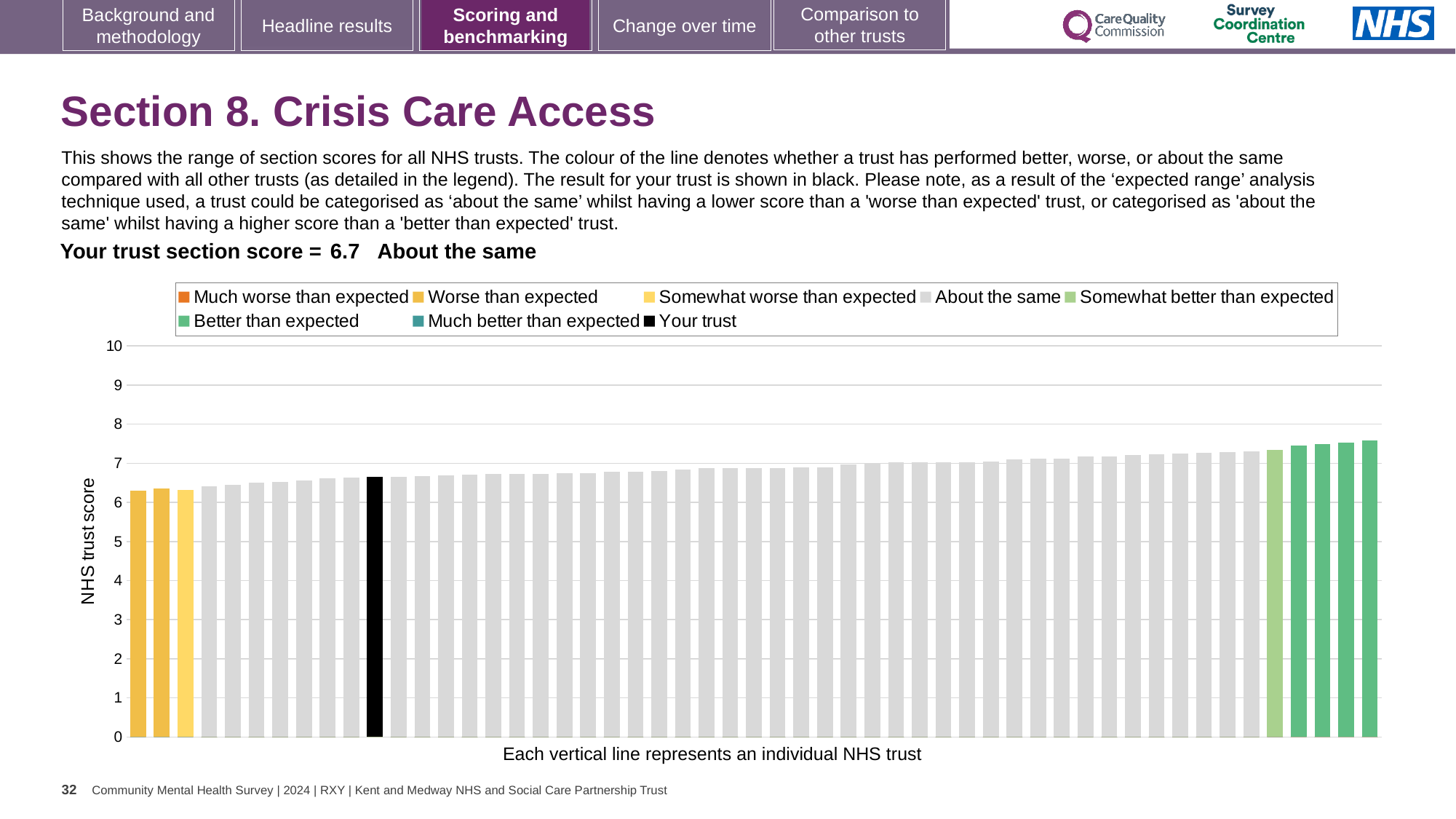
What is the label on the vertical axis of the chart? NHS trust score What is the section score for your trust shown on the slide? 6.7 What colour is the bar representing your trust? black Which legend category does the tallest bar on the chart belong to? Better than expected Is the value of the tallest bar on the chart greater or less than 7? greater How many entries does the chart legend list? 8 Do the bar values rise or fall from left to right along the x axis? rise Is the value of the black bar (your trust) greater or less than 7? less How many bars are coloured as 'Worse than expected' (yellow)? 2 What kind of chart is shown on the slide? bar chart Is the value of the shortest bar on the chart greater or less than 6? greater